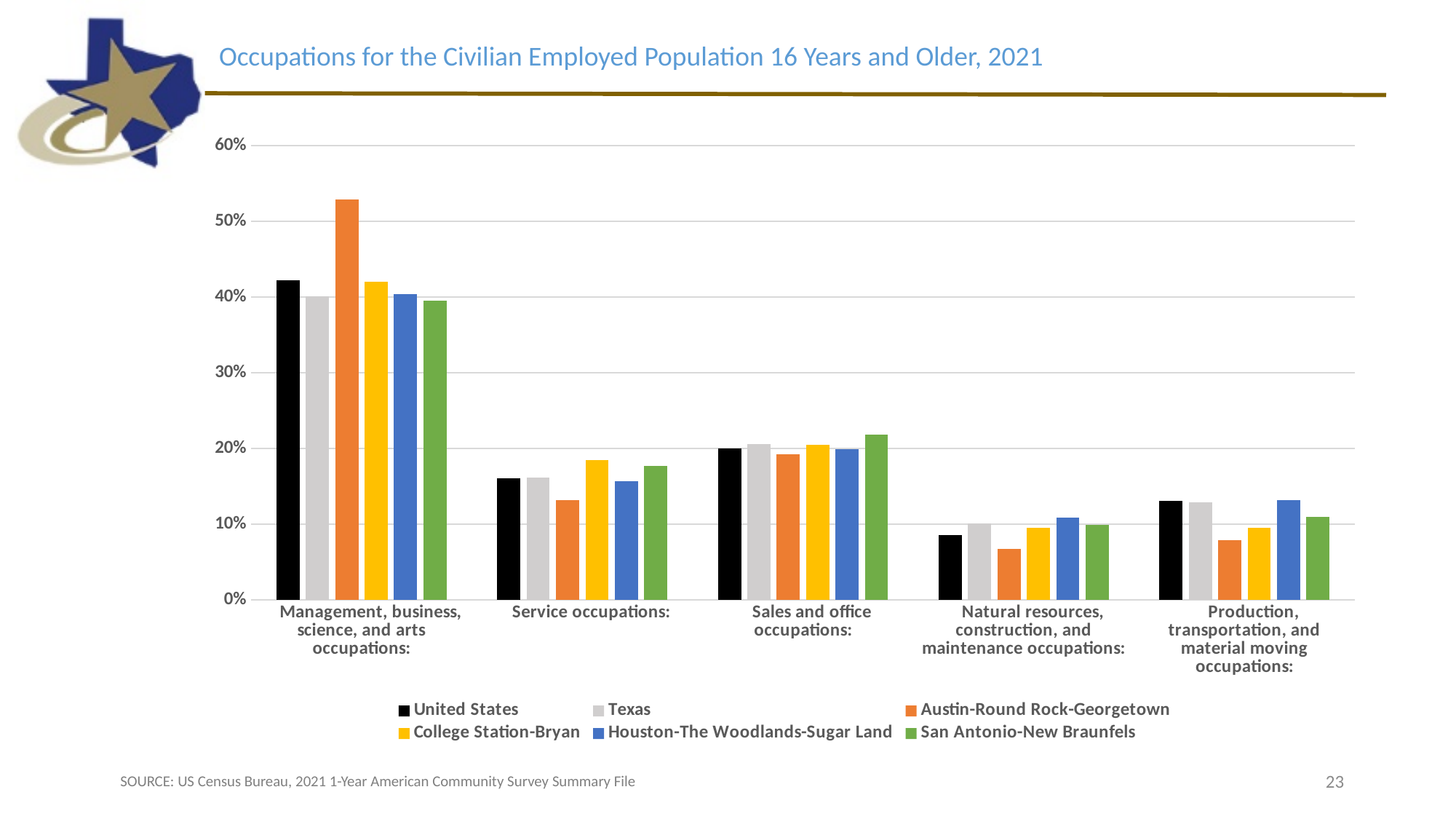
Which series has the highest value for Sales and office occupations? San Antonio-New Braunfels How many occupation categories are shown on the x axis? 5 What colour represents Austin-Round Rock-Georgetown in the legend? orange How many series does the legend list? 6 Which series has the lowest value for Service occupations? Austin-Round Rock-Georgetown Is the value for Austin-Round Rock-Georgetown in Management, business, science, and arts occupations greater or less than 50%? greater Is the value for Austin-Round Rock-Georgetown in Production, transportation, and material moving occupations greater or less than 10%? less Which series has the highest value for Management, business, science, and arts occupations? Austin-Round Rock-Georgetown What kind of chart is shown on the slide? bar chart In Service occupations, which is larger: College Station-Bryan or Austin-Round Rock-Georgetown? College Station-Bryan Is the value for Austin-Round Rock-Georgetown in Natural resources, construction, and maintenance occupations greater or less than 10%? less Which series has the lowest value for Production, transportation, and material moving occupations? Austin-Round Rock-Georgetown